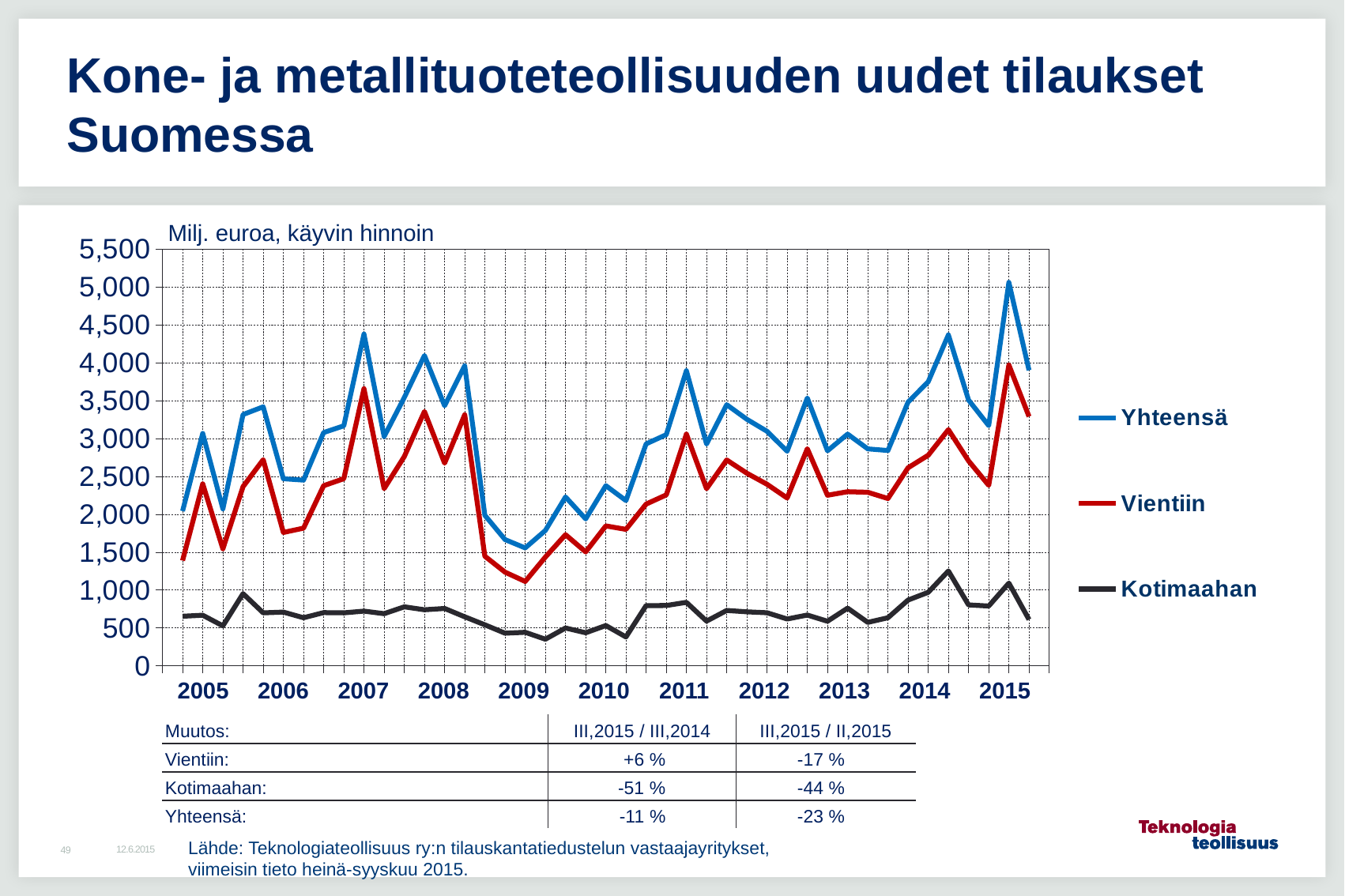
Which series has the highest values throughout the chart? Yhteensä Is the peak value of Kotimaahan in 2014 greater or less than 1,000? greater Is the lowest value of Vientiin in 2009 greater or less than 1,500? less Is the peak value of Yhteensä in 2015 greater or less than 4,500? greater Which is larger in 2007, the peak of Yhteensä or the peak of Vientiin? Yhteensä Which series is shown in red in the legend? Vientiin How many series does the legend list? 3 What kind of chart is shown on the slide? line chart Do the Yhteensä values rise or fall from 2008 to 2009? fall Which series has the lowest values throughout the chart? Kotimaahan What unit is stated above the chart? Milj. euroa, käyvin hinnoin